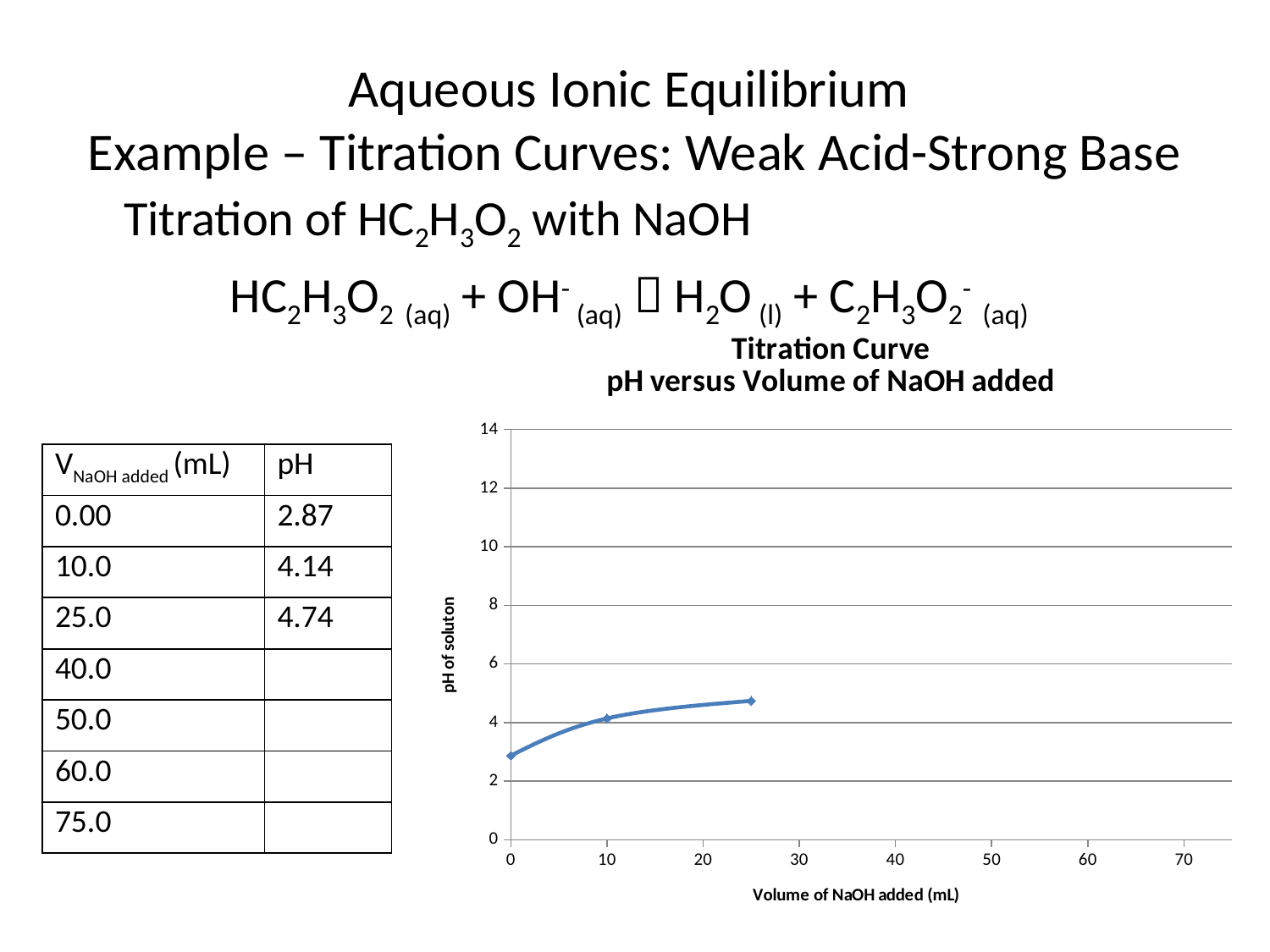
What is the pH plotted at 0.00 mL of NaOH added, as given in the table on the slide? 2.87 What kind of chart is shown on the slide? line chart Which plotted point has the larger pH, the one at 10 mL or the one at 25 mL of NaOH added? 25 mL What is the label of the x axis of the chart? Volume of NaOH added (mL) At which volume of NaOH added is the plotted pH highest? 25.0 mL Is the pH plotted at 25 mL of NaOH added greater or less than 6? less Is the pH plotted at 0 mL of NaOH added greater or less than 4? less Is the pH plotted at 25 mL of NaOH added greater or less than 4? greater How many data points are plotted on the chart? 3 What is the title of the chart? Titration Curve pH versus Volume of NaOH added At which volume of NaOH added is the plotted pH lowest? 0.00 mL Does the pH rise or fall as the volume of NaOH added increases along the x axis? rise